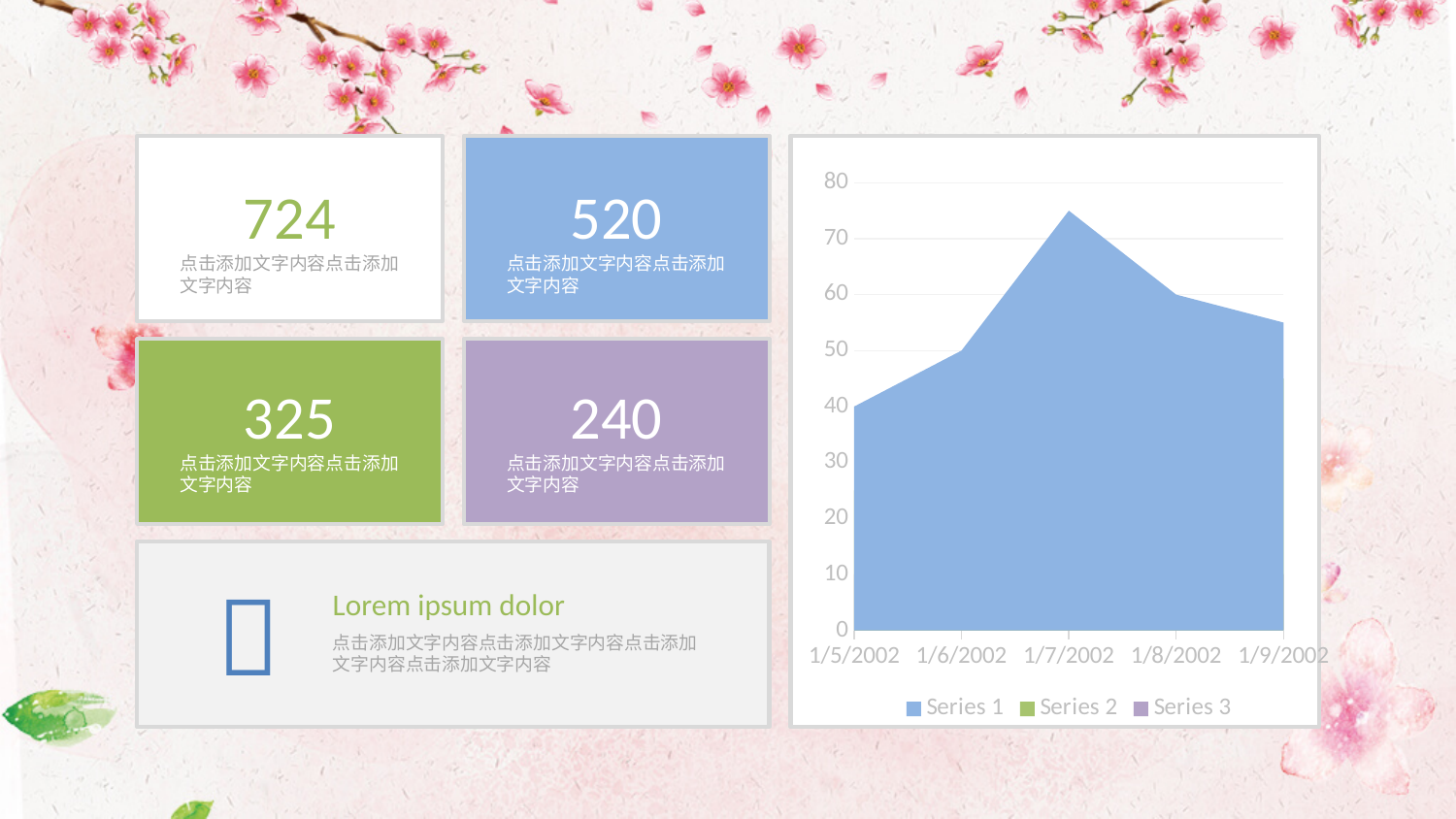
What kind of chart is shown on the slide? area chart Is the value for 1/7/2002 greater or less than 70? greater On which date does Series 1 have its lowest value? 1/5/2002 How many series does the chart legend list? 3 How many dates are shown along the x axis of the chart? 5 What are the entries listed in the chart legend? Series 1, Series 2, Series 3 What is the value for 1/5/2002? 40 Do the values rise or fall from 1/5/2002 to 1/7/2002? rise Is the value for 1/9/2002 greater or less than 50? greater Which is larger, the value for 1/8/2002 or the value for 1/9/2002? 1/8/2002 Do the values rise or fall from 1/7/2002 to 1/9/2002? fall On which date does Series 1 reach its highest value? 1/7/2002